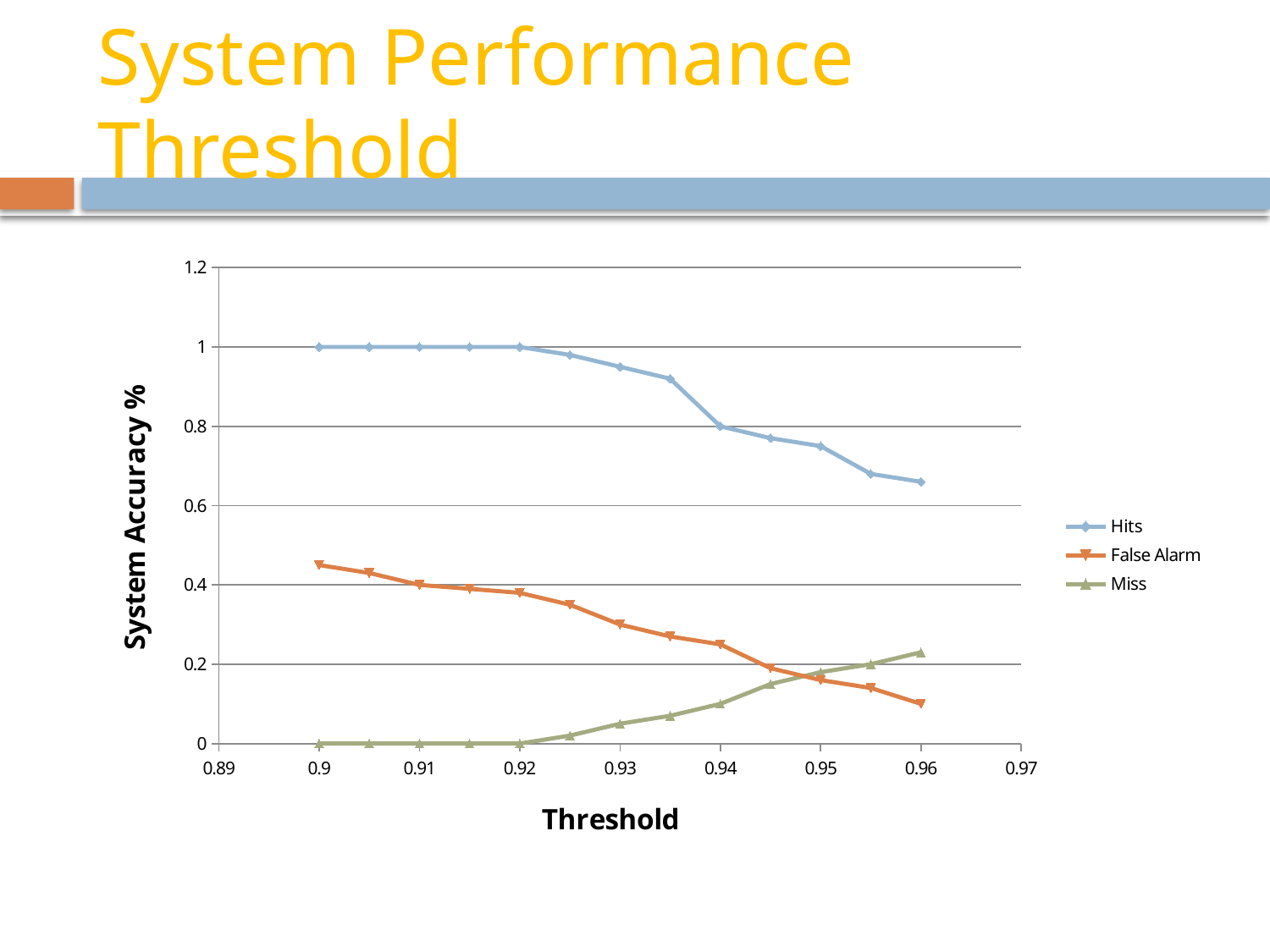
What kind of chart is shown on the slide? line chart How many series does the legend list? 3 What is the title of the x axis? Threshold What is the Miss value at a threshold of 0.91? 0 Is the False Alarm value at a threshold of 0.9 greater or less than 0.4? greater What is the Hits value at a threshold of 0.9? 1 Is the Hits value at a threshold of 0.96 greater or less than 0.6? greater Does the Miss series rise or fall as the threshold increases? rise Is the Hits value at a threshold of 0.95 greater or less than 0.8? less At a threshold of 0.96, which is larger: False Alarm or Miss? Miss Does the Hits series rise or fall as the threshold increases? fall